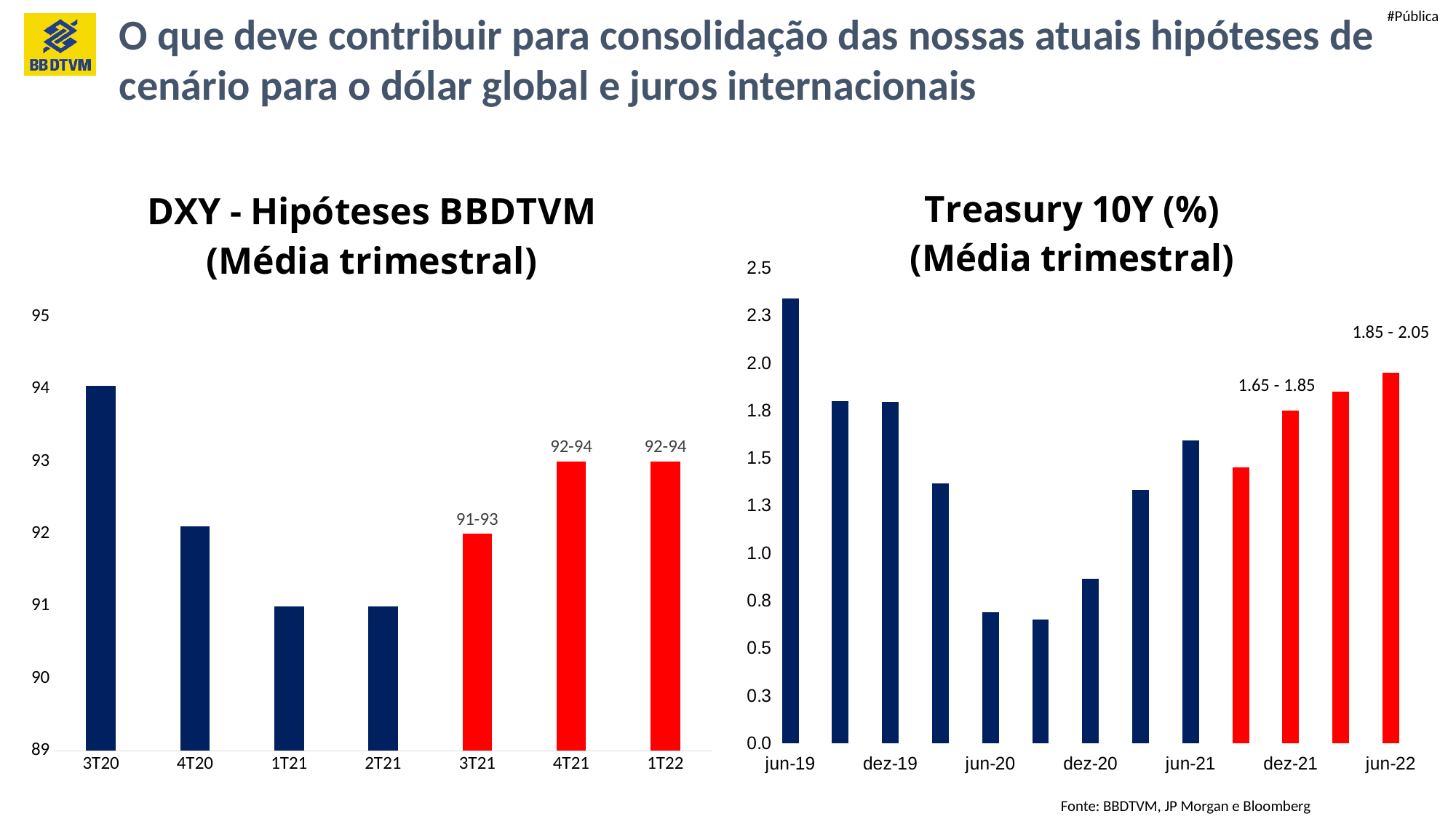
In the 'DXY - Hipóteses BBDTVM (Média trimestral)' chart, what is the data label shown for 3T21? 91-93 How many categories are shown on the x axis of the 'DXY - Hipóteses BBDTVM (Média trimestral)' chart? 7 In the 'DXY - Hipóteses BBDTVM (Média trimestral)' chart, what colour are the bars for 3T21, 4T21 and 1T22? red What kind of chart is the 'DXY - Hipóteses BBDTVM (Média trimestral)' chart? bar chart In the 'Treasury 10Y (%) (Média trimestral)' chart, is the value for jun-20 greater or less than 1.0? less In the 'DXY - Hipóteses BBDTVM (Média trimestral)' chart, what is the data label shown for 1T22? 92-94 In the 'Treasury 10Y (%) (Média trimestral)' chart, what is the data label shown for jun-22? 1.85 - 2.05 In the 'Treasury 10Y (%) (Média trimestral)' chart, what is the data label shown for dez-21? 1.65 - 1.85 In the 'DXY - Hipóteses BBDTVM (Média trimestral)' chart, is the value for 3T20 greater or less than 93? greater In the 'DXY - Hipóteses BBDTVM (Média trimestral)' chart, which category has the highest bar? 3T20 In the 'DXY - Hipóteses BBDTVM (Média trimestral)' chart, which is larger, the value for 4T20 or the value for 1T21? 4T20 In the 'Treasury 10Y (%) (Média trimestral)' chart, which labelled period has the highest bar? jun-19